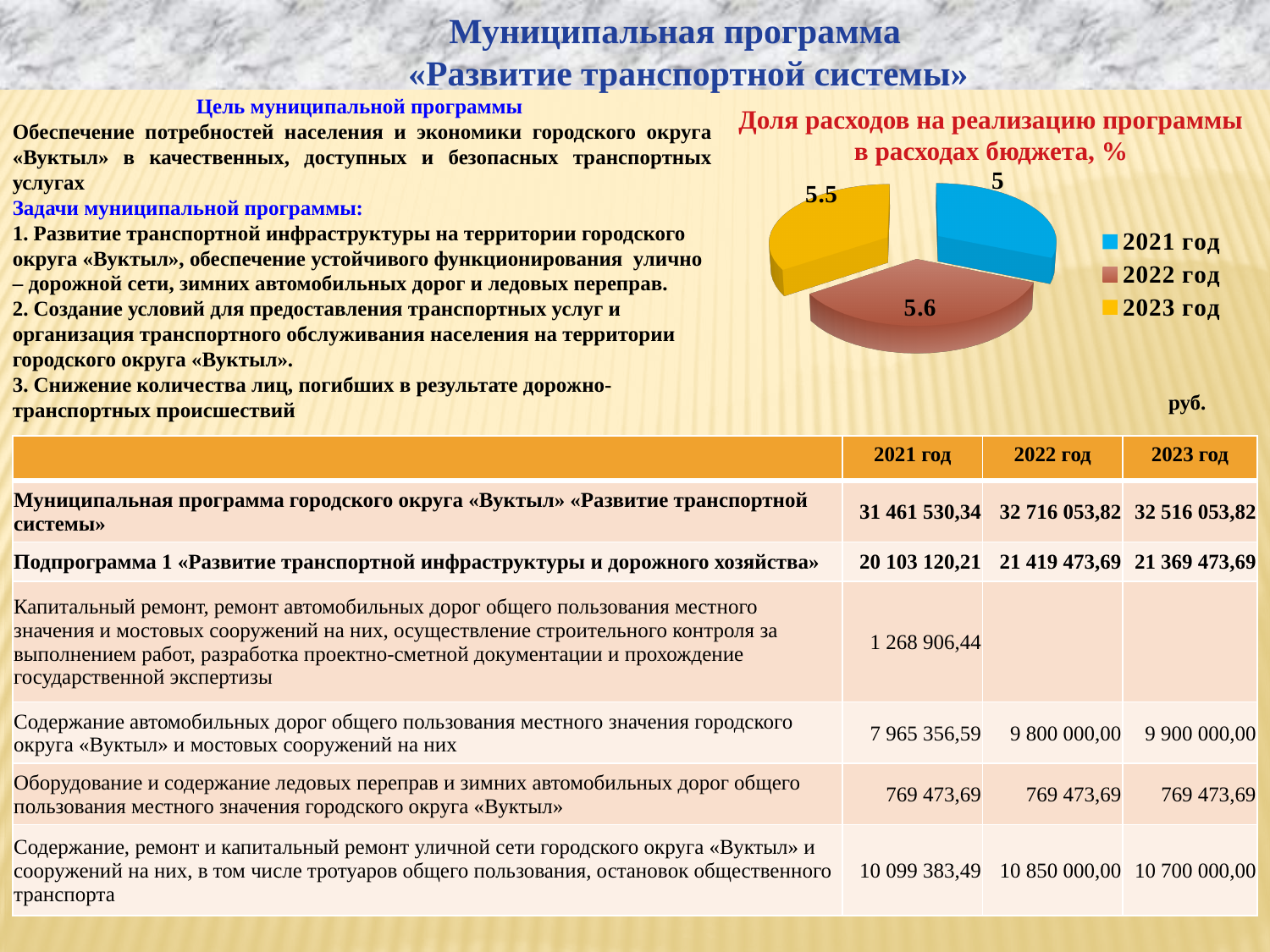
What is the difference between the values for 2023 год and 2021 год in the pie chart? 0.5 How many slices does the pie chart have? 3 What is the difference between the values for 2022 год and 2021 год in the pie chart? 0.6 What value does the pie chart show for 2023 год? 5.5 What is the title of the pie chart? Доля расходов на реализацию программы в расходах бюджета, % What value does the pie chart show for 2022 год? 5.6 Which year has the largest slice in the pie chart? 2022 год What kind of chart is shown on the slide? Pie chart What value does the pie chart show for 2021 год? 5 Which year has the smallest slice in the pie chart? 2021 год Which is larger in the pie chart, the value for 2023 год or the value for 2021 год? 2023 год How many entries does the legend of the pie chart list? 3